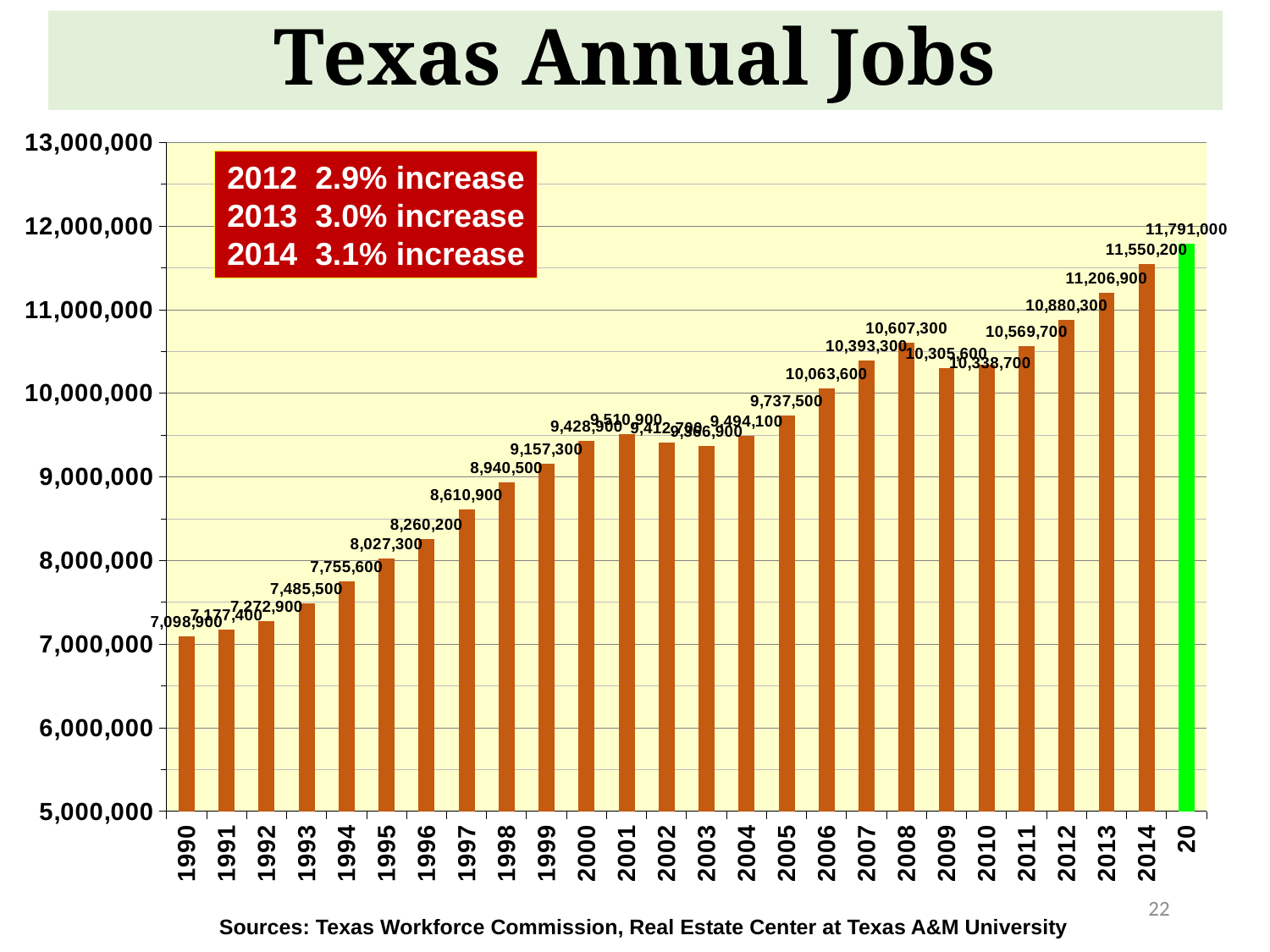
According to the red text box, what was the percentage increase in 2014? 3.1% increase What kind of chart is shown on the slide? bar chart Which year has the lowest value on the chart? 1990 What is the value for 2014? 11,550,200 What is the difference between the values for 2014 and 2013? 343,300 What is the value for 2000? 9,428,900 By how much did the value fall from 2008 to 2009? 301,700 Is the value for 2005 greater or less than 10,000,000? less What value is printed above the green bar at the far right of the chart? 11,791,000 Which is larger, the value for 2008 or the value for 2009? 2008 Among the years 1990 through 2014, which year has the highest value? 2014 What is the value for 2008? 10,607,300